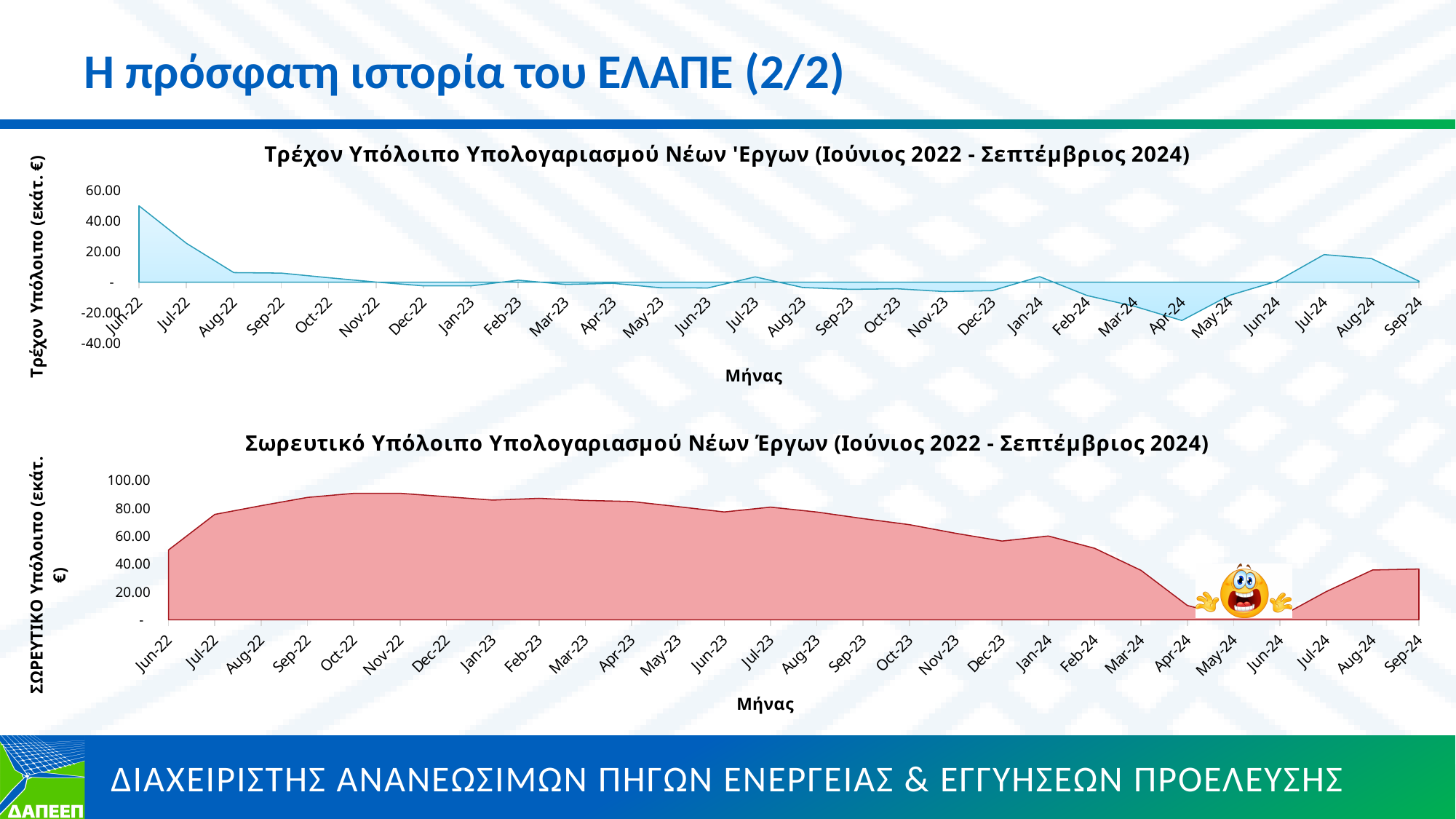
In the bottom chart (Σωρευτικό Υπόλοιπο), do the values rise or fall from Jan-24 to Apr-24? fall What kind of chart is the top chart, 'Τρέχον Υπόλοιπο Υπολογαριασμού Νέων Έργων'? Area chart In the top chart (Τρέχον Υπόλοιπο), which month has the highest value? Jun-22 In the bottom chart (Σωρευτικό Υπόλοιπο), is the value for Jun-22 greater or less than 40.00? greater In the bottom chart (Σωρευτικό Υπόλοιπο), which is larger: the value for Jul-22 or the value for Sep-24? Jul-22 In the bottom chart (Σωρευτικό Υπόλοιπο), which month has the lowest value? May-24 In the top chart (Τρέχον Υπόλοιπο), which month has the lowest value? Apr-24 In the top chart (Τρέχον Υπόλοιπο), is the value for Jun-22 greater or less than 40.00? greater What is the x-axis title of the bottom chart (Σωρευτικό Υπόλοιπο)? Μήνας In the top chart (Τρέχον Υπόλοιπο), is the value for Apr-24 greater or less than -20.00? less How many months are plotted along the x axis of the top chart (Τρέχον Υπόλοιπο)? 28